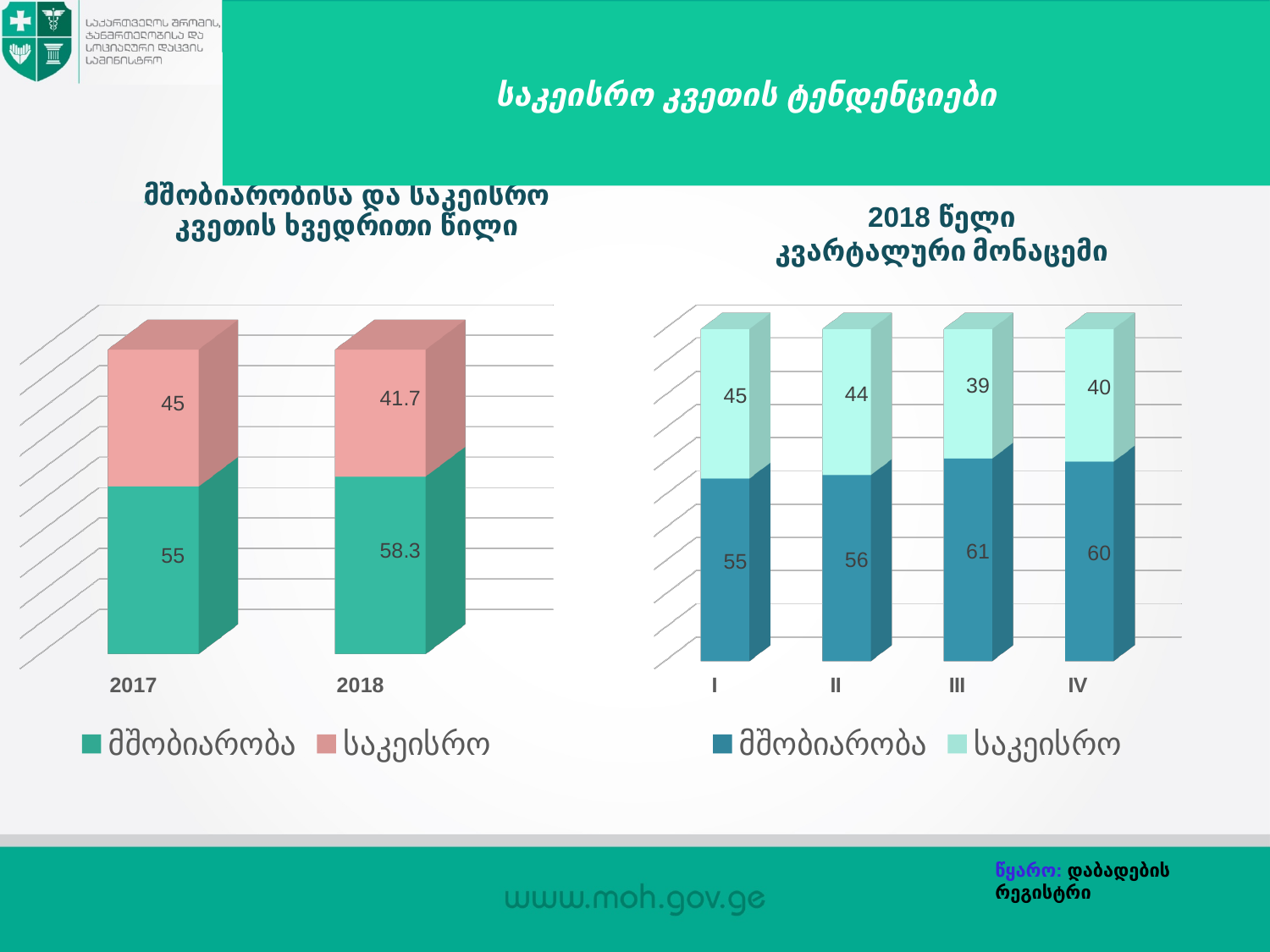
In the right chart, is the საკეისრო value for quarter I larger or smaller than the საკეისრო value for quarter II? larger In the left chart, what is the value for მშობიარობა in 2017? 55 In the right chart, what is the value for საკეისრო in quarter IV? 40 In the right chart, which quarter has the lowest საკეისრო value? III In the left chart, what is the difference between the მშობიარობა values for 2018 and 2017? 3.3 In the left chart, how many series does the legend list? 2 In the left chart, what is the total of the stacked bar for 2018? 100 In the right chart (2018 წელი კვარტალური მონაცემი), what is the value for მშობიარობა in quarter III? 61 In the left chart (მშობიარობისა და საკეისრო კვეთის ხვედრითი წილი), what is the value for საკეისრო in 2018? 41.7 In the right chart, how many quarters are shown on the x axis? 4 What kind of chart is the right chart? Stacked bar chart In the right chart, which quarter has the highest მშობიარობა value? III